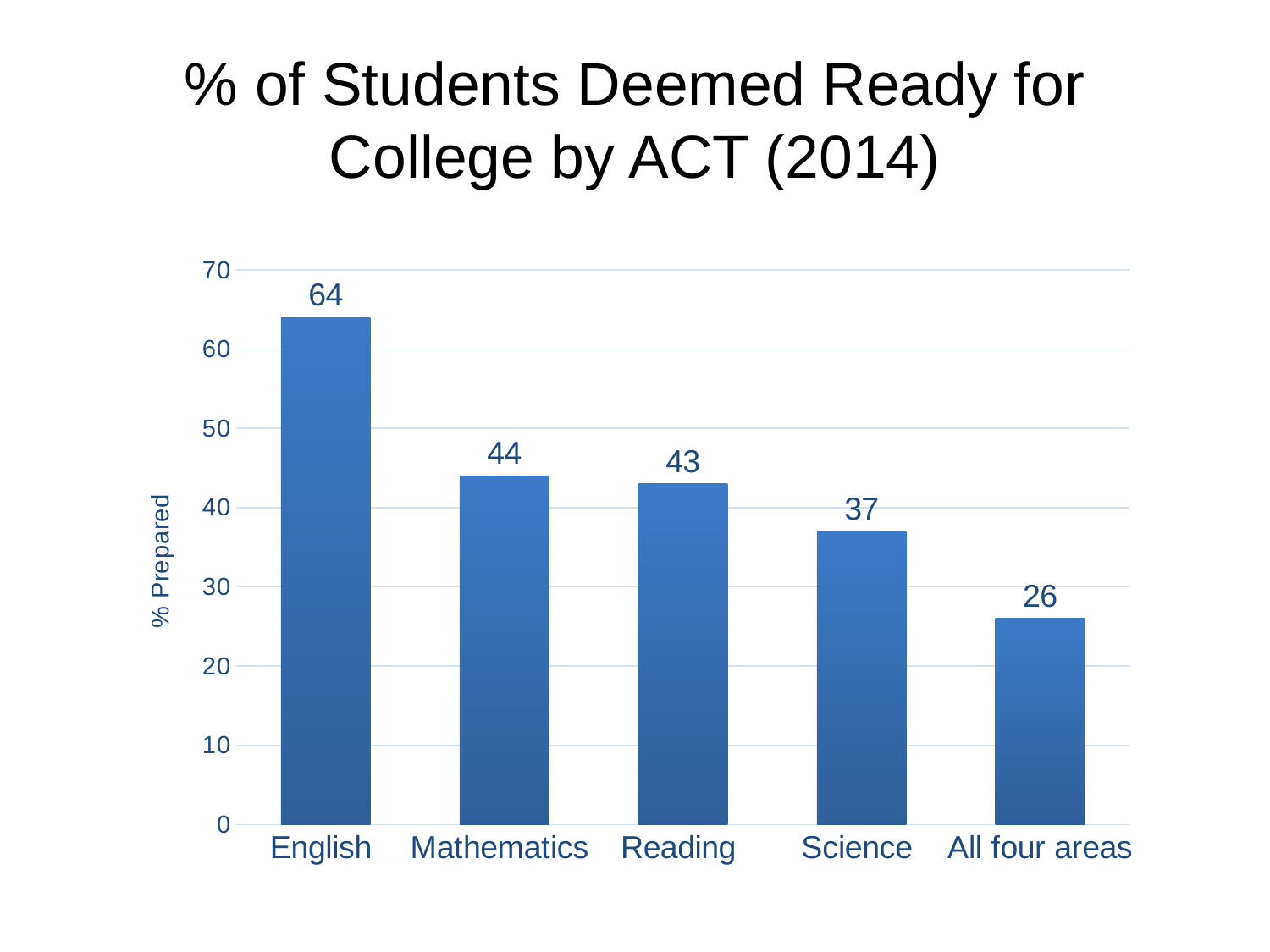
What is the difference between the values for Science and All four areas? 11 What is the value for All four areas? 26 Which is larger, the value for Mathematics or the value for Science? Mathematics Do the values rise or fall from left to right along the x axis? Fall Which category has the highest value? English What is the difference between the values for English and Mathematics? 20 What is the label of the y axis? % Prepared What kind of chart is this? Bar chart What is the value for English? 64 What is the value for Science? 37 Which category has the lowest value? All four areas How many categories are shown on the x axis? 5